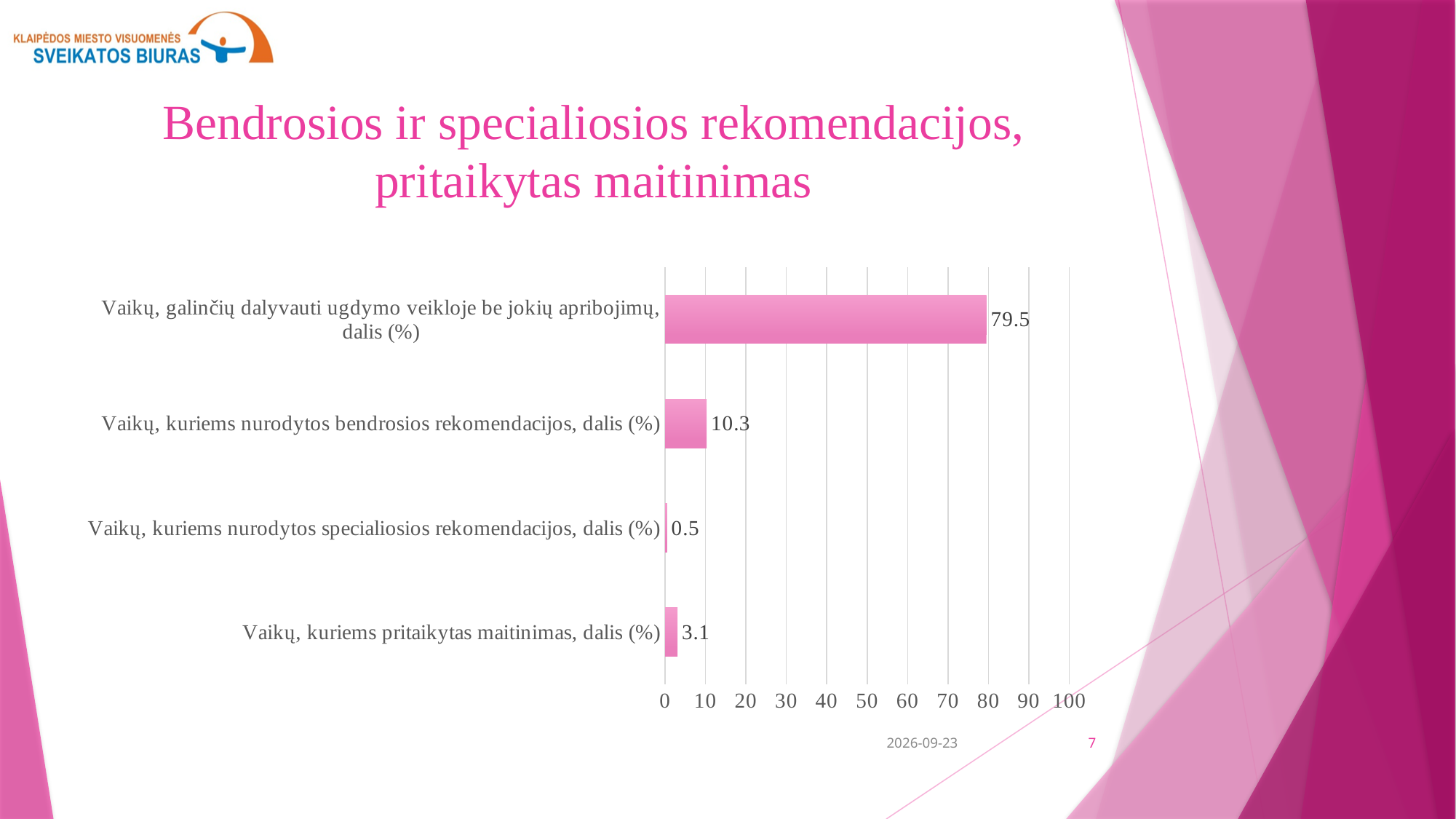
Is the value for "Vaikų, galinčių dalyvauti ugdymo veikloje be jokių apribojimų, dalis (%)" greater or less than 70? greater Which category has the lowest value? Vaikų, kuriems nurodytos specialiosios rekomendacijos, dalis (%) What is the value for "Vaikų, kuriems nurodytos specialiosios rekomendacijos, dalis (%)"? 0.5 What is the maximum value shown on the horizontal axis? 100 How many categories are shown in the chart? 4 Which is larger: the value for "Vaikų, kuriems pritaikytas maitinimas, dalis (%)" or for "Vaikų, kuriems nurodytos specialiosios rekomendacijos, dalis (%)"? Vaikų, kuriems pritaikytas maitinimas, dalis (%) What kind of chart is shown on the slide? bar chart Which category has the highest value? Vaikų, galinčių dalyvauti ugdymo veikloje be jokių apribojimų, dalis (%) What is the value for "Vaikų, kuriems nurodytos bendrosios rekomendacijos, dalis (%)"? 10.3 What is the value for "Vaikų, galinčių dalyvauti ugdymo veikloje be jokių apribojimų, dalis (%)"? 79.5 What is the value for "Vaikų, kuriems pritaikytas maitinimas, dalis (%)"? 3.1 What is the difference between the values for "Vaikų, kuriems nurodytos bendrosios rekomendacijos, dalis (%)" and "Vaikų, kuriems pritaikytas maitinimas, dalis (%)"? 7.2